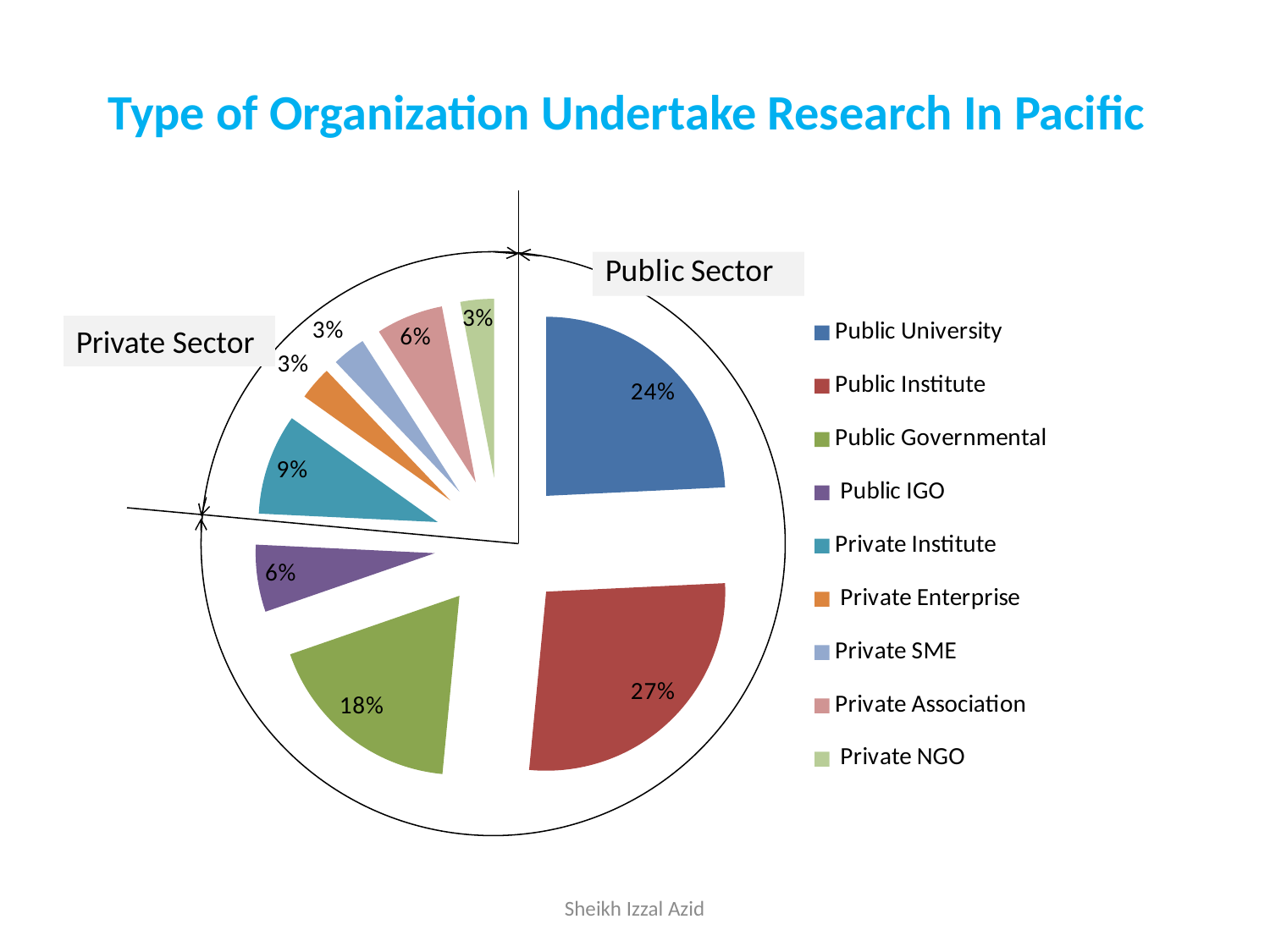
What is the value for Private Association? 6% What is the title of the chart? Type of Organization Undertake Research In Pacific Which is larger, the share for Public Governmental or the share for Private Institute? Public Governmental What is the value for Public Governmental? 18% How many slices does the pie chart have? 9 What is the value for Private Institute? 9% What share of the pie does Public Institute hold? 27% What is the combined share of the four Public Sector categories (Public University, Public Institute, Public Governmental, Public IGO)? 75% What is the value for Public University? 24% What is the difference between the Public Institute and Public University shares? 3% What type of chart is shown on the slide? pie chart Which category has the largest share of the pie? Public Institute